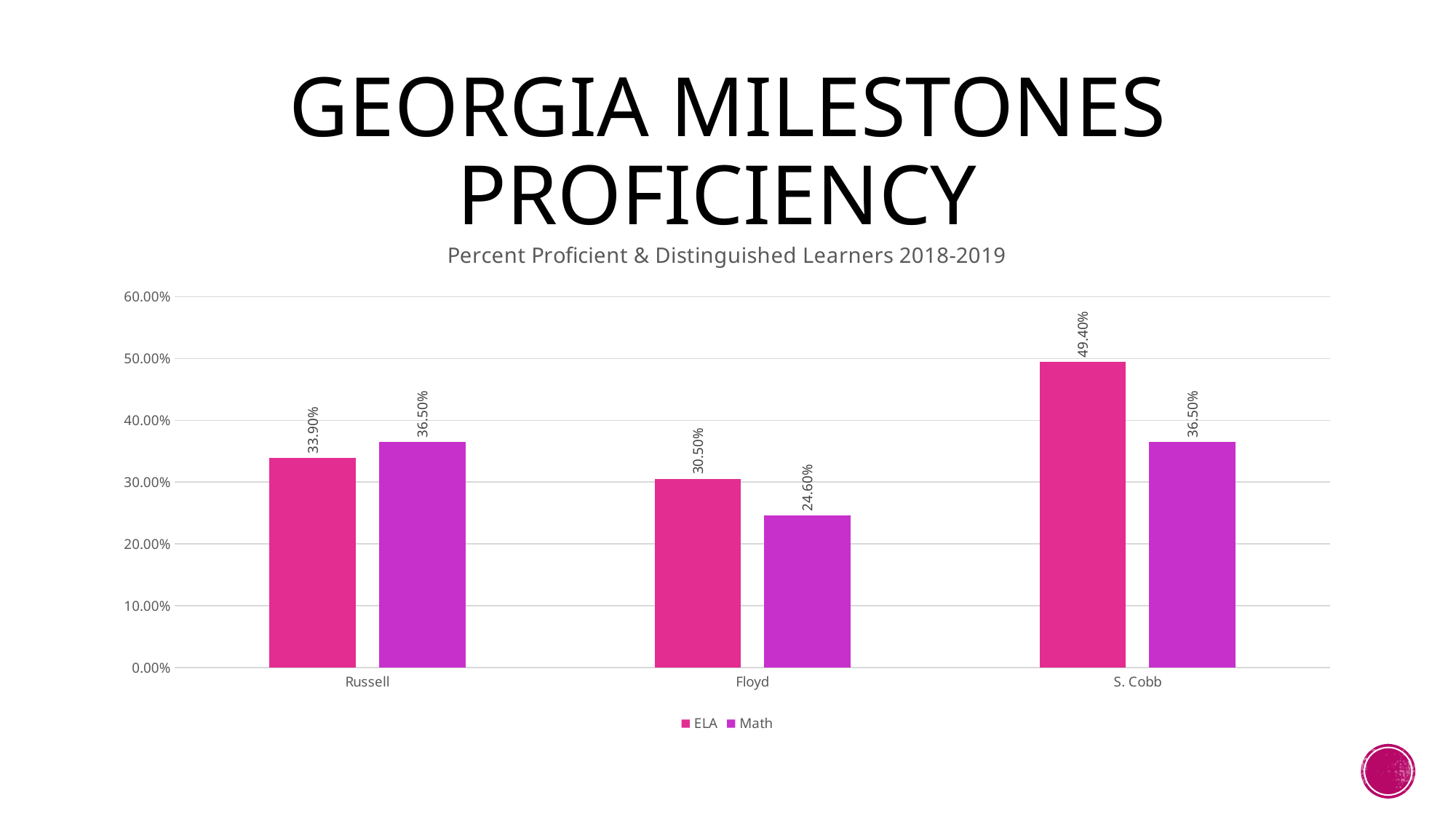
What is the difference between the ELA values for S. Cobb and Russell? 15.50% Is the ELA value for Floyd greater or less than 40.00%? less Which school has the lowest Math value? Floyd How many series does the legend list? 2 What kind of chart is shown on the slide? bar chart How many schools are shown on the x axis? 3 What is the ELA value for S. Cobb? 49.40% What is the ELA value for Russell? 33.90% Which is larger for Russell, the ELA value or the Math value? Math What is the difference between the ELA and Math values for Floyd? 5.90% What is the Math value for Floyd? 24.60% Which school has the highest ELA value? S. Cobb